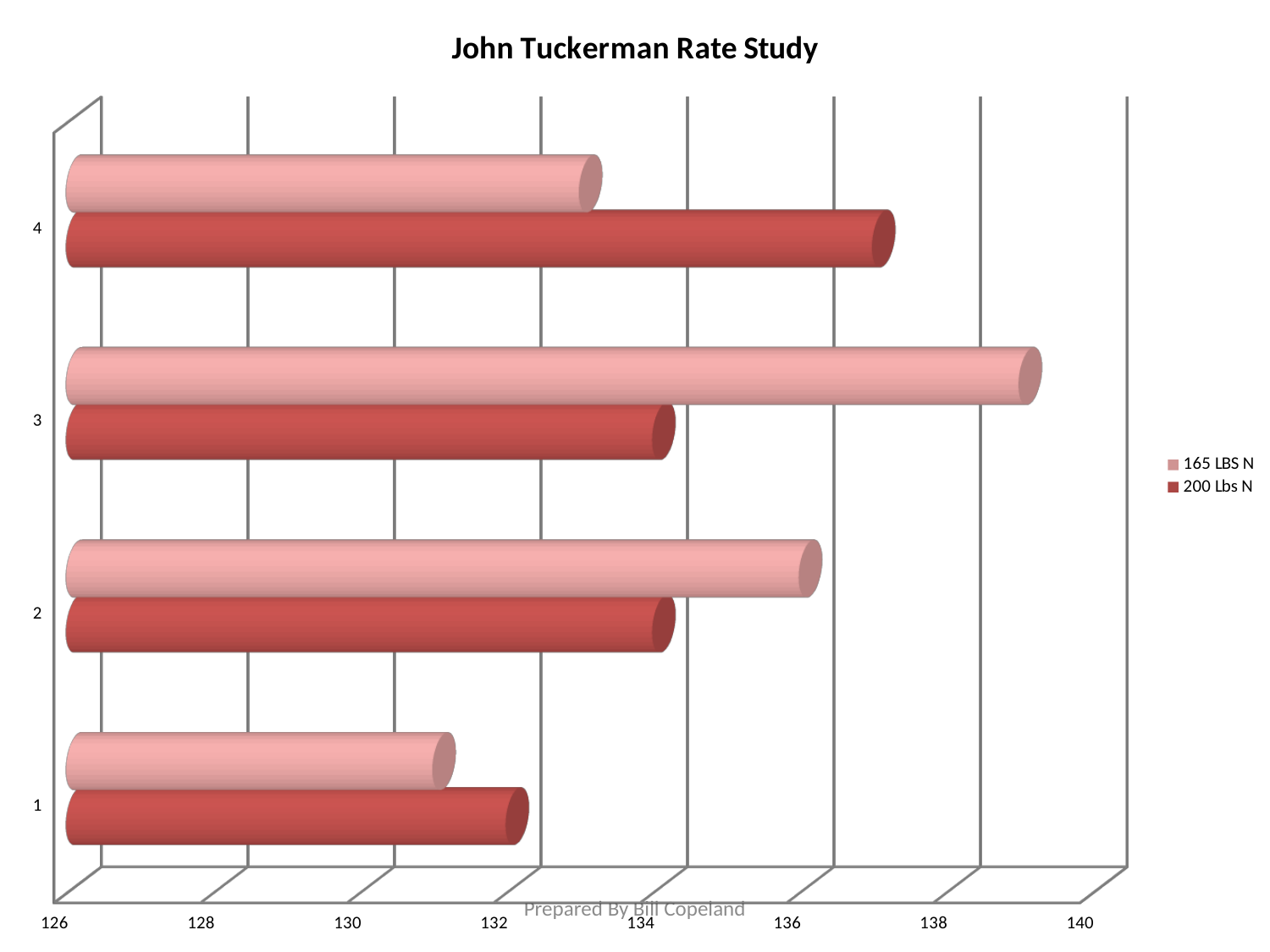
Which category has the lowest value for the 200 Lbs N series? 1 In category 4, which series has the larger value, 165 LBS N or 200 Lbs N? 200 Lbs N What kind of chart is shown on the slide? bar chart How many series does the legend list? 2 Is the value for 165 LBS N in category 3 greater or less than 138? greater Which category has the highest value for the 200 Lbs N series? 4 What is the title of the chart? John Tuckerman Rate Study What are the two series named in the legend? 165 LBS N and 200 Lbs N Which category has the lowest value for the 165 LBS N series? 1 In category 3, which series has the larger value, 165 LBS N or 200 Lbs N? 165 LBS N Which category has the highest value for the 165 LBS N series? 3 How many categories are shown on the vertical axis? 4